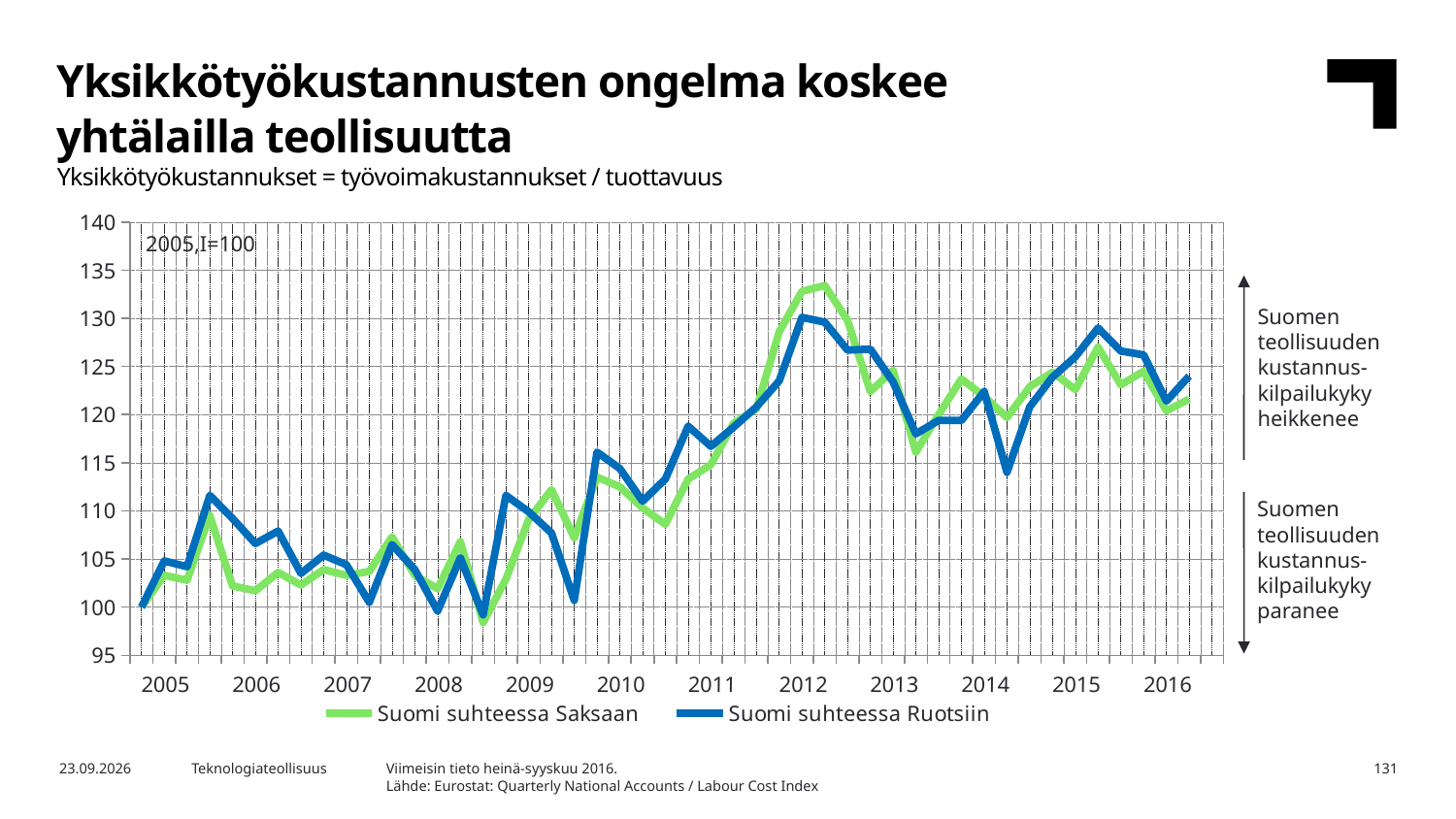
Which series reaches the highest value anywhere on the chart? Suomi suhteessa Saksaan Overall, do the values rise or fall from 2005 to 2016? rise What kind of chart is shown on the slide? line chart Is the lowest value of Suomi suhteessa Ruotsiin in 2009 greater or less than 105? less What is the value of both series at the start of 2005? 100 Is the lowest value of Suomi suhteessa Ruotsiin in 2014 greater or less than 120? less Is the lowest value of Suomi suhteessa Saksaan in 2008 greater or less than 100? less How many series does the legend list? 2 What is the base value of the index, as stated on the chart? 2005,I=100 Which two series are listed in the legend? Suomi suhteessa Saksaan; Suomi suhteessa Ruotsiin At the 2012 peak, which series is higher: Suomi suhteessa Saksaan or Suomi suhteessa Ruotsiin? Suomi suhteessa Saksaan